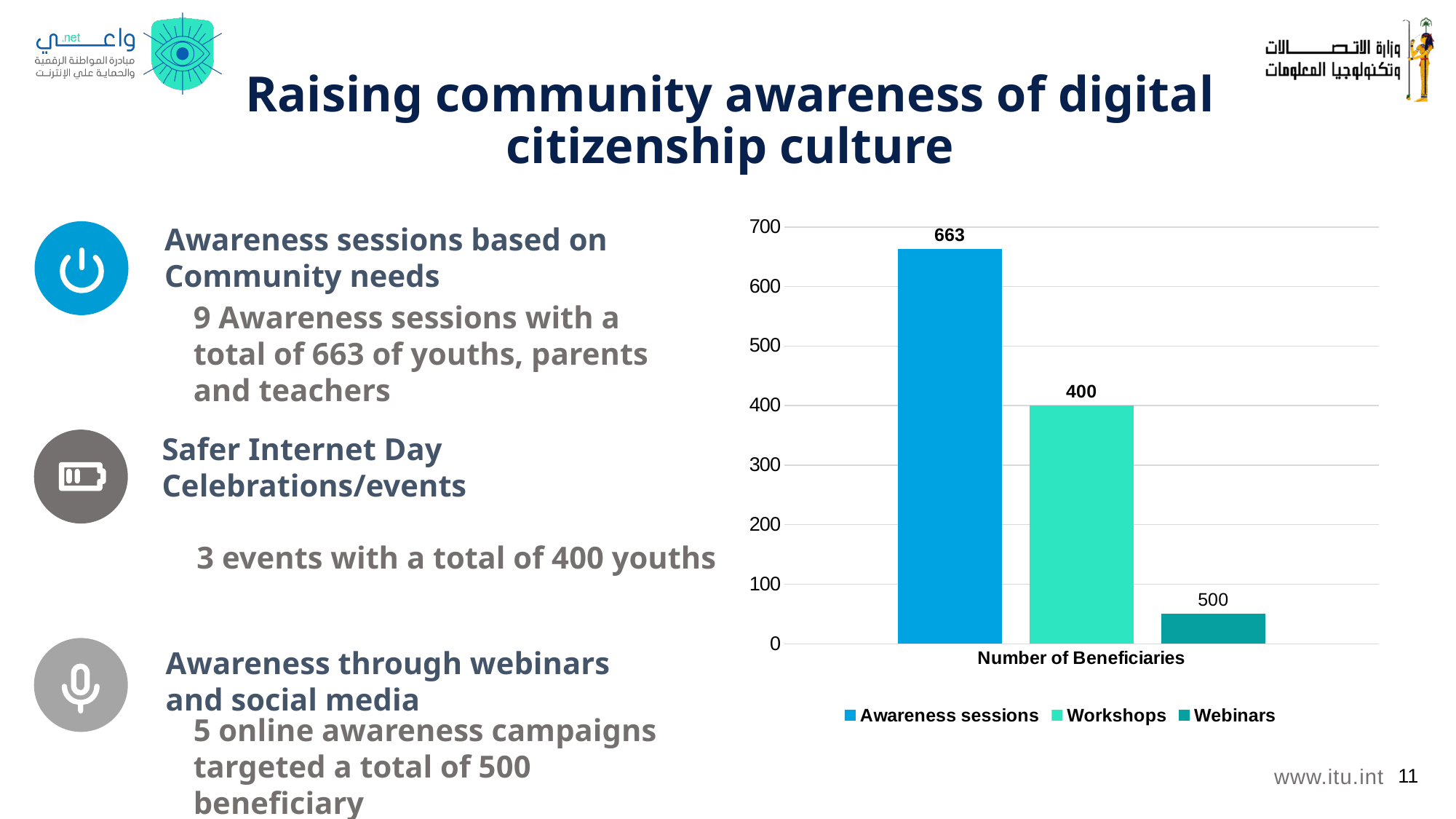
What is the category label shown under the bars on the x axis? Number of Beneficiaries What value is shown for Awareness sessions in the chart? 663 Which is larger, the value for Awareness sessions or the value for Workshops? Awareness sessions How many bars are plotted in the chart? 3 What data label is printed above the Webinars bar? 500 Is the value for Awareness sessions greater or less than 600? greater What value is shown for Workshops in the chart? 400 Is the value for Workshops greater or less than 300? greater Which series has the highest value in the chart? Awareness sessions What is the difference between the Awareness sessions value and the Workshops value? 263 What kind of chart is shown on the slide? Bar chart How many series does the chart legend list? 3